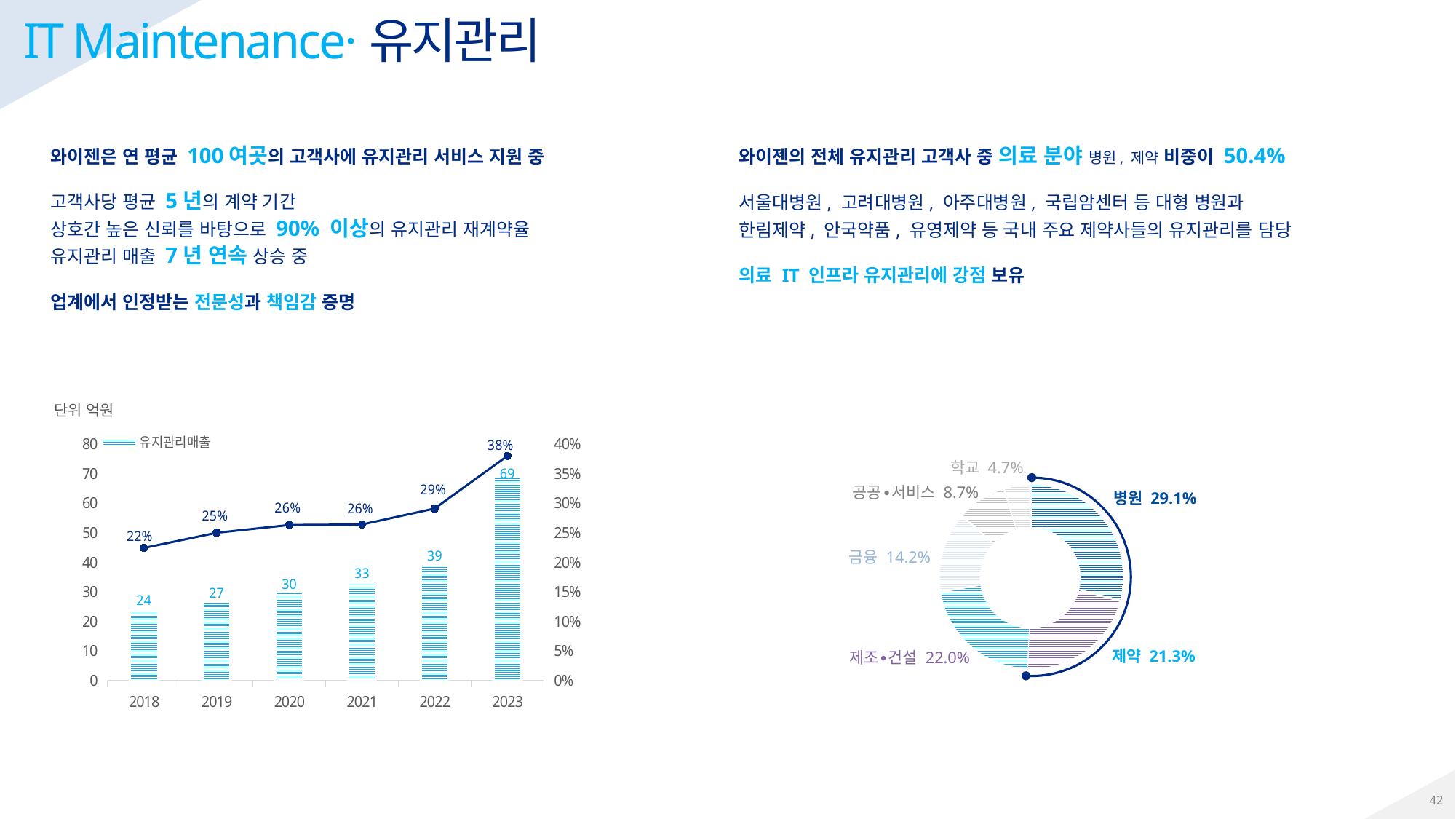
In the right donut chart, what share does 병원 have? 29.1% In the left chart, do the 유지관리매출 bars rise or fall from 2018 to 2023? rise In the right donut chart, which category has the smallest share? 학교 In the right donut chart, which is larger, 제조•건설 or 제약? 제조•건설 In the left chart, what percentage does the line show for 2022? 29% In the right donut chart, what share does 금융 have? 14.2% In the left chart, which year has the lowest percentage on the line? 2018 In the left chart, what is the difference between the 유지관리매출 values for 2023 and 2022? 30 In the left chart, which year has the highest 유지관리매출 bar? 2023 How many years are shown on the x axis of the left chart? 6 In the left chart, what is the 유지관리매출 value for 2023? 69 In the left chart, what is the 유지관리매출 value for 2018? 24